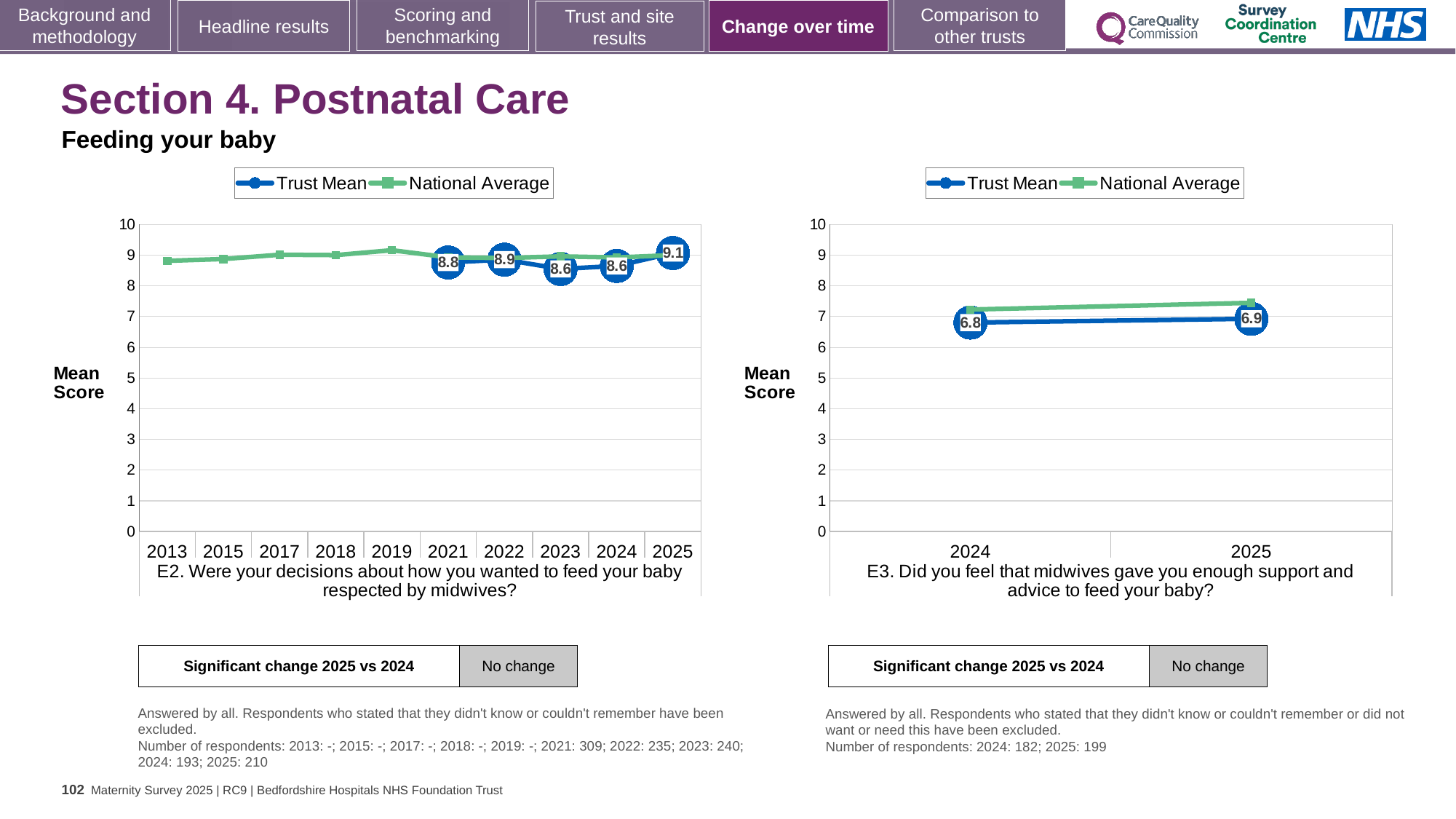
In the E2 chart (left), what is the difference between the Trust Mean in 2025 and in 2024? 0.5 What kind of chart is the E3 chart (right)? Line chart In the E2 chart (left), is the Trust Mean higher in 2022 or in 2023? 2022 In the E2 chart (left), which year has the highest Trust Mean? 2025 In the E3 chart (right), how many series does the legend list? 2 In the E2 chart (left), how many years are shown on the x axis? 10 In the E3 chart (right), what is the Trust Mean for 2024? 6.8 In the E2 chart (left), is the National Average for 2013 greater or less than 8? greater In the E3 chart (right), what is the Trust Mean for 2025? 6.9 In the E3 chart (right), is the National Average for 2025 greater or less than 7? greater In the E2 chart (left), what is the Trust Mean for 2025? 9.1 In the E2 chart (left), what is the Trust Mean for 2021? 8.8